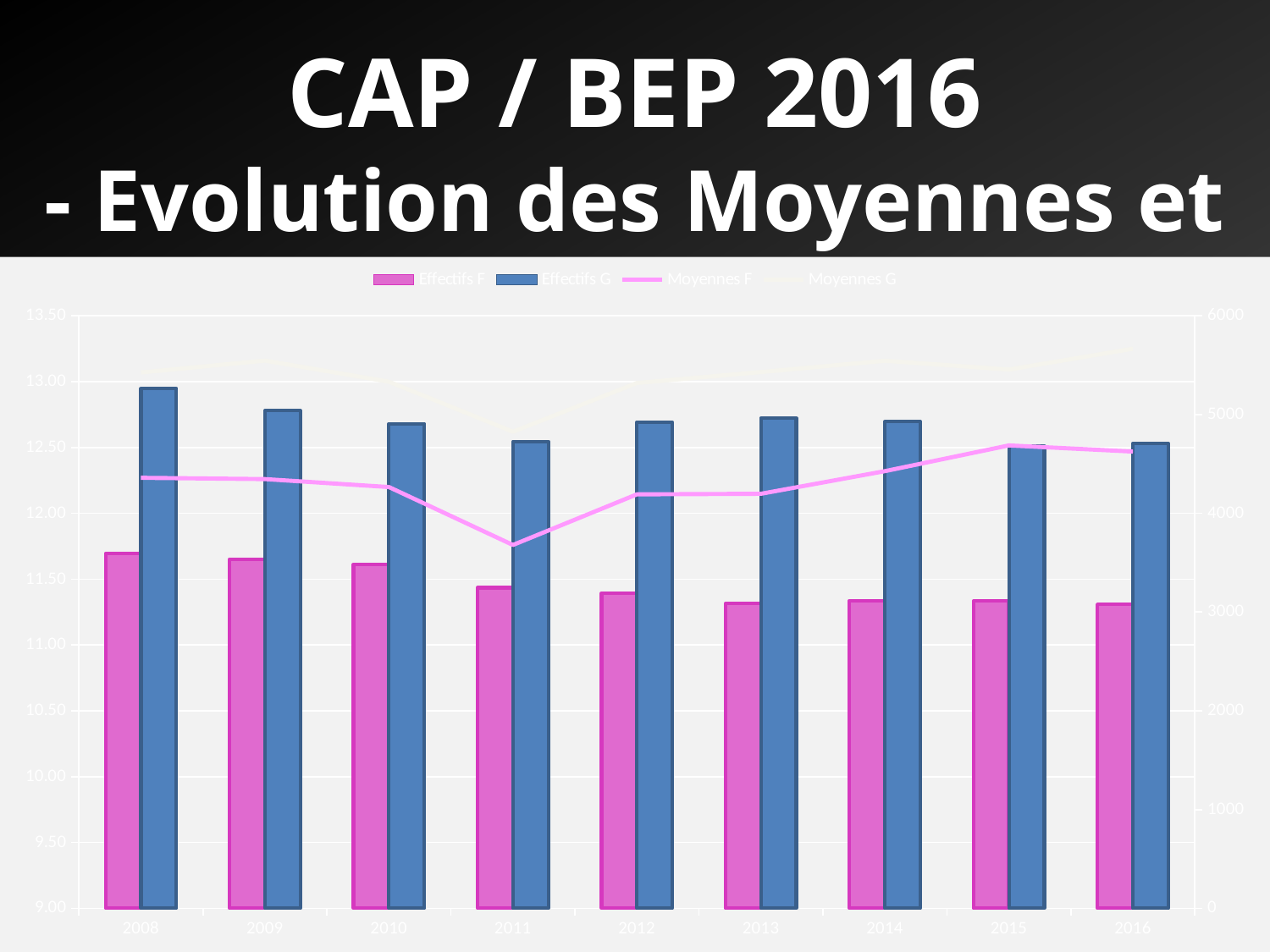
What colour are the Effectifs F bars? Pink Do the Effectifs F bars generally rise or fall from 2008 to 2016? fall How many years are shown on the x axis? 9 Is the Moyennes F value for 2011 greater or less than 12.00? less In which year does the Moyennes F line reach its lowest point? 2011 In 2012, which bar is taller, Effectifs F or Effectifs G? Effectifs G Which year has the tallest Effectifs G bar? 2008 Is the Effectifs G value for 2008 greater or less than 5000? greater What kind of chart is this? Combined bar and line chart How many series does the legend list? 4 Is the Effectifs G bar taller in 2008 or in 2016? 2008 In which year does the Moyennes G line reach its highest point? 2016